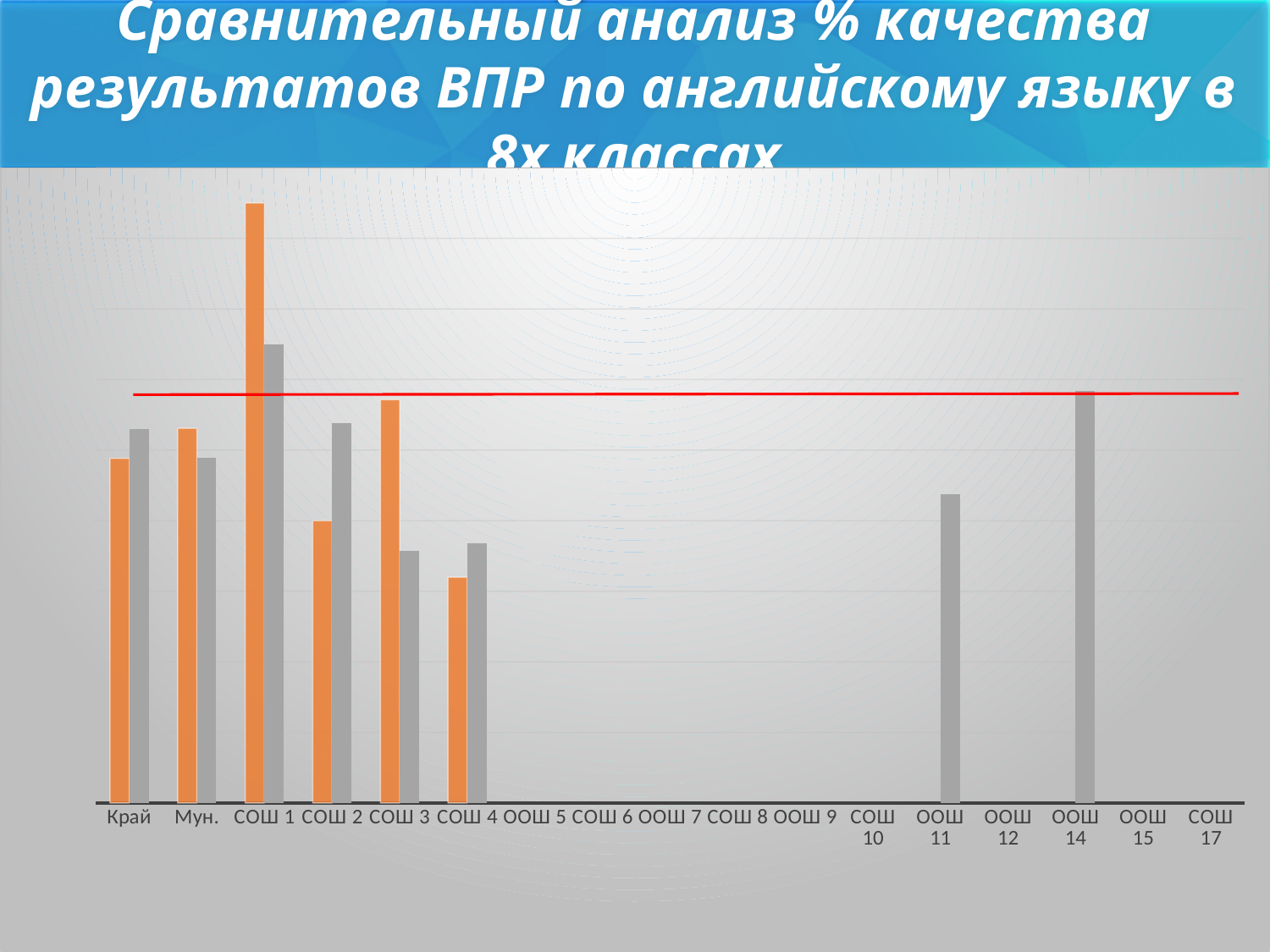
For Край, which bar is taller, the orange one or the grey one? grey How many categories have only a grey bar and no orange bar? 2 What colour is the horizontal reference line drawn across the chart? red Among the categories with an orange bar, which has the shortest orange bar? СОШ 4 For СОШ 2, which bar is taller, the orange one or the grey one? grey How many categories on the x axis have no bars at all? 9 Which category has the tallest orange bar? СОШ 1 How many categories are listed along the x axis of the chart? 17 Which grey bar is taller, ООШ 11 or ООШ 14? ООШ 14 What kind of chart is shown on the slide? bar chart Which category has the tallest grey bar? СОШ 1